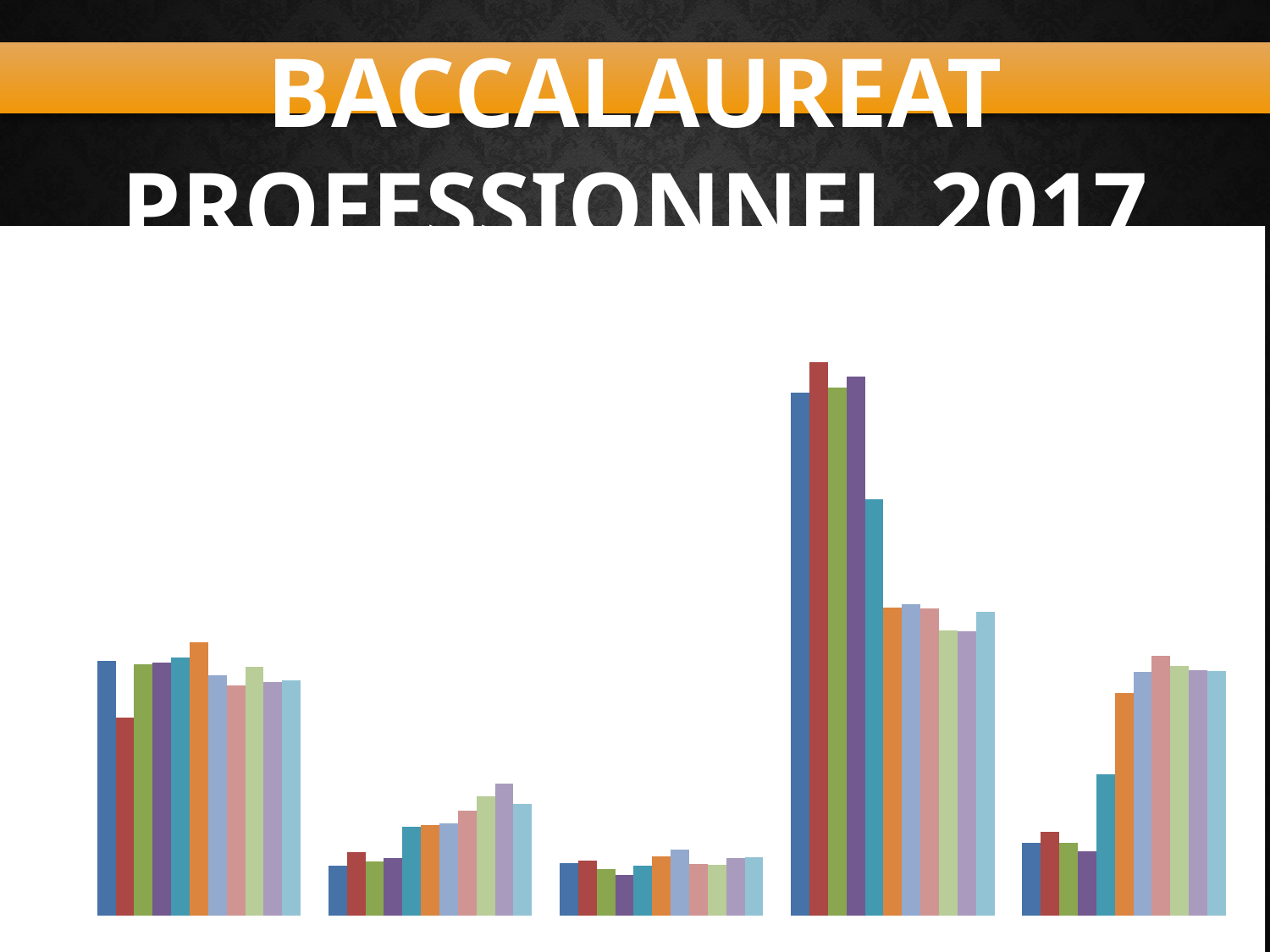
Are the bars in the first group from the left taller or shorter than the bars in the second group? taller How many groups of bars does the chart show? 5 How many bars are in each group of the chart? 11 Within the fourth group from the left, is the tallest bar the red one or the teal one? the red one Which group of bars (counting from the left) contains the tallest bars? the fourth group What kind of chart is shown on the slide? bar chart What is the title shown at the top of the slide? BACCALAUREAT PROFESSIONNEL 2017 Does the chart display a legend? No Which group of bars (counting from the left) has the lowest bars overall? the third group